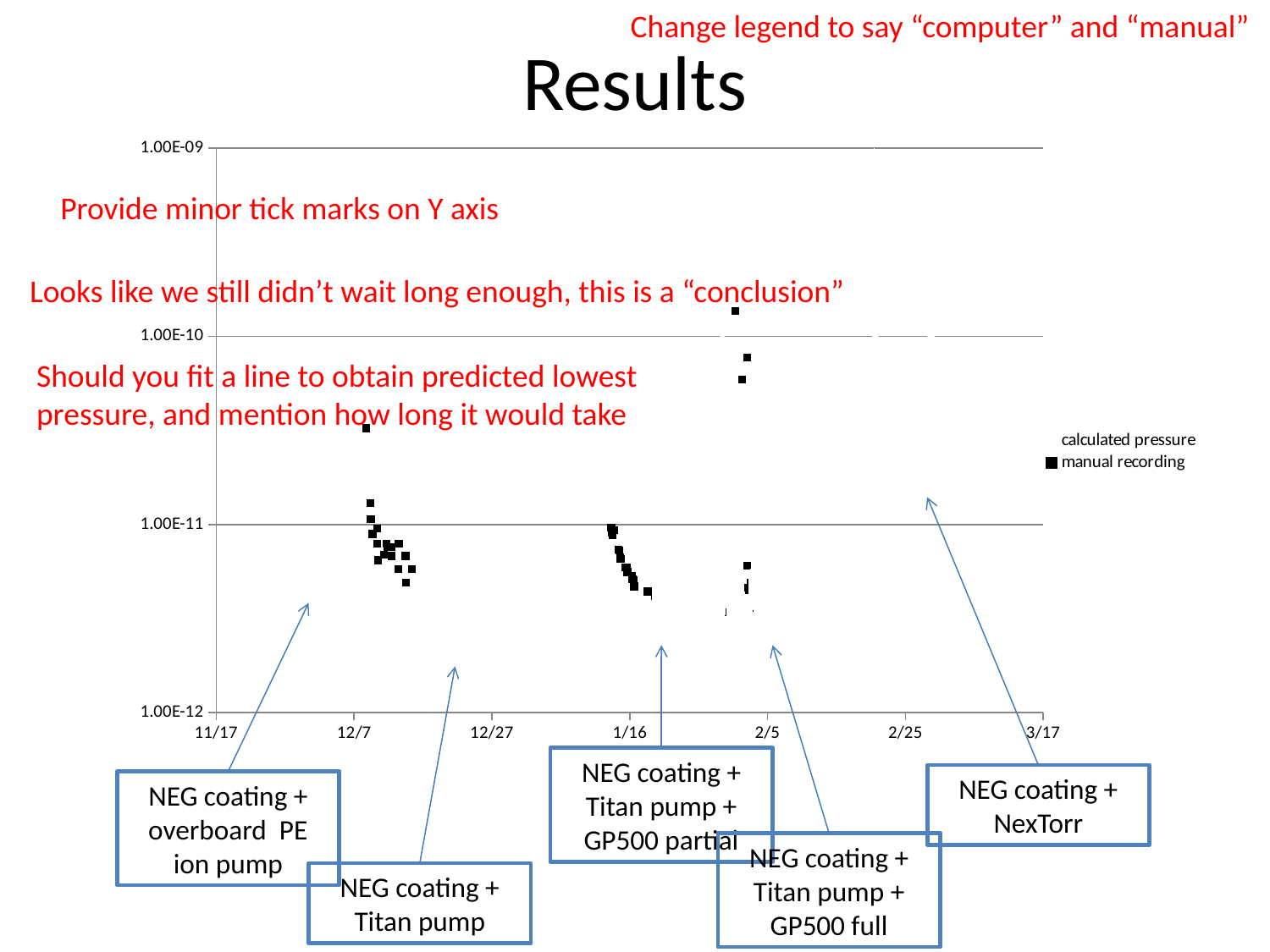
Within the cluster of points starting near 1/16, do the values rise or fall over time? fall Which cluster contains the highest plotted value: the one near 12/7 or the one near 2/5? near 2/5 How many tick labels are shown on the y axis? 4 Is the highest plotted point, located just before 2/5, greater or less than 1.00E-10? greater Is the highest point in the cluster near 12/7 greater or less than 1.00E-10? less How many series does the chart legend list? 2 Within the cluster of points starting near 12/7, do the values generally rise or fall over time? fall Is the lowest point in the cluster near 1/16 greater or less than 1.00E-12? greater What kind of chart is shown on the slide? scatter chart What are the two entries in the chart legend? calculated pressure and manual recording What is the title of the slide containing the chart? Results How many date labels are shown on the x axis? 7